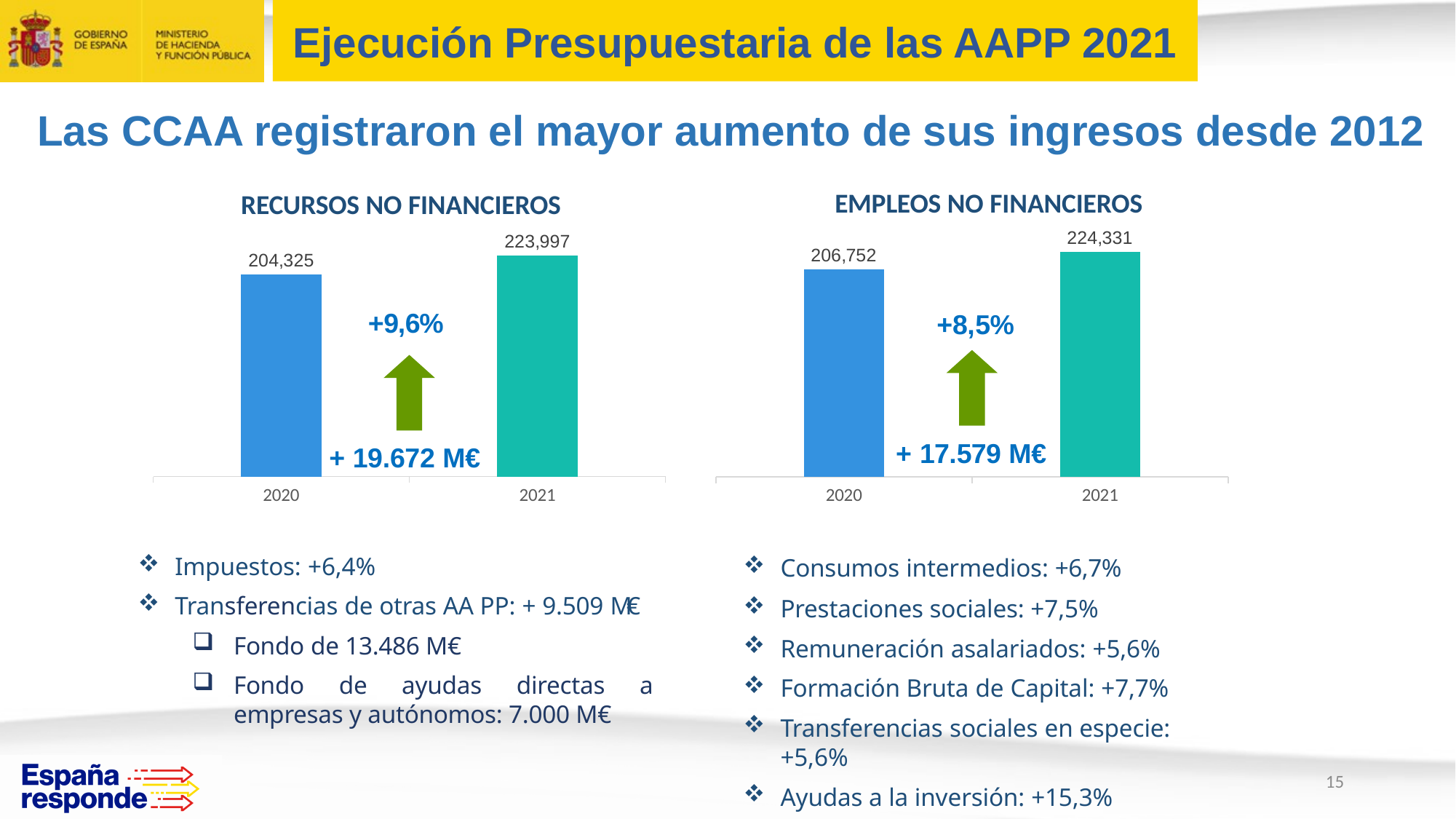
In the EMPLEOS NO FINANCIEROS chart, is the value for 2021 larger or smaller than the value for 2020? larger In the RECURSOS NO FINANCIEROS chart, which year has the higher value? 2021 What kind of chart is the EMPLEOS NO FINANCIEROS chart? bar chart In the EMPLEOS NO FINANCIEROS chart, which year has the lower value? 2020 In the EMPLEOS NO FINANCIEROS chart, what is the value for 2020? 206,752 What percentage change is shown between the bars in the RECURSOS NO FINANCIEROS chart? +9,6% In the RECURSOS NO FINANCIEROS chart, what is the value for 2020? 204,325 In the RECURSOS NO FINANCIEROS chart, what is the value for 2021? 223,997 In the RECURSOS NO FINANCIEROS chart, what is the difference between the 2021 and 2020 values? 19,672 In the EMPLEOS NO FINANCIEROS chart, what is the difference between the 2021 and 2020 values? 17,579 In the EMPLEOS NO FINANCIEROS chart, what is the value for 2021? 224,331 How many bars are shown in the RECURSOS NO FINANCIEROS chart? 2